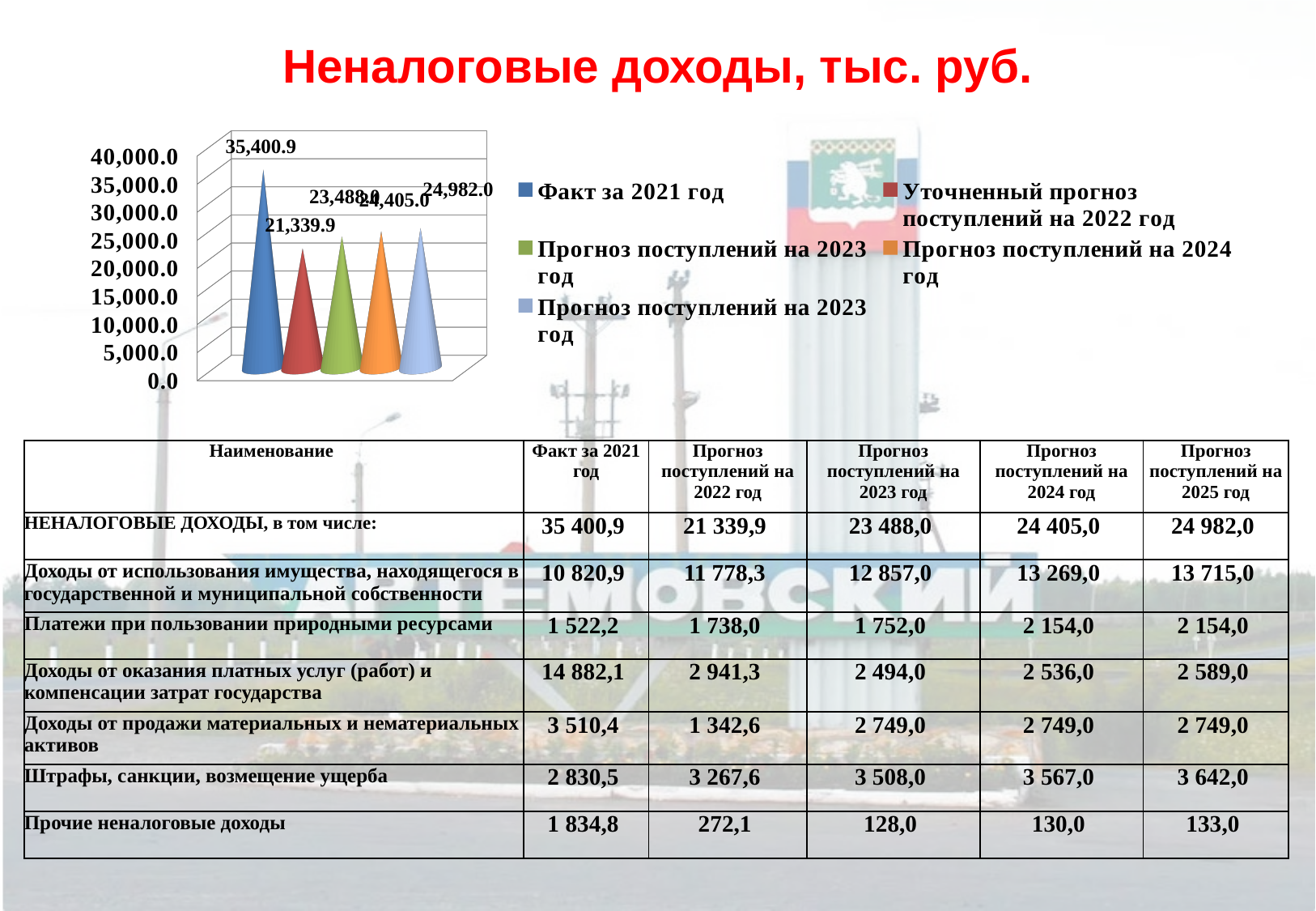
What is the data label on the rightmost (light blue) cone in the chart? 24,982.0 Is the value for 'Факт за 2021 год' greater or less than 30,000.0? greater What is the value of the data label on the blue cone for 'Факт за 2021 год'? 35,400.9 What value does the chart show for 'Прогноз поступлений на 2024 год'? 24,405.0 What type of chart is shown on the slide? bar chart (3D cone) What is the difference between the value for 'Факт за 2021 год' and the value for 'Уточненный прогноз поступлений на 2022 год'? 14,061.0 How many series does the chart legend list? 5 Which is larger: the value for 'Прогноз поступлений на 2024 год' or the value for 'Уточненный прогноз поступлений на 2022 год'? Прогноз поступлений на 2024 год Which series has the lowest value in the chart? Уточненный прогноз поступлений на 2022 год What is the title of the slide above the chart? Неналоговые доходы, тыс. руб. What value is shown for 'Уточненный прогноз поступлений на 2022 год' in the chart? 21,339.9 Which series has the highest value in the chart? Факт за 2021 год